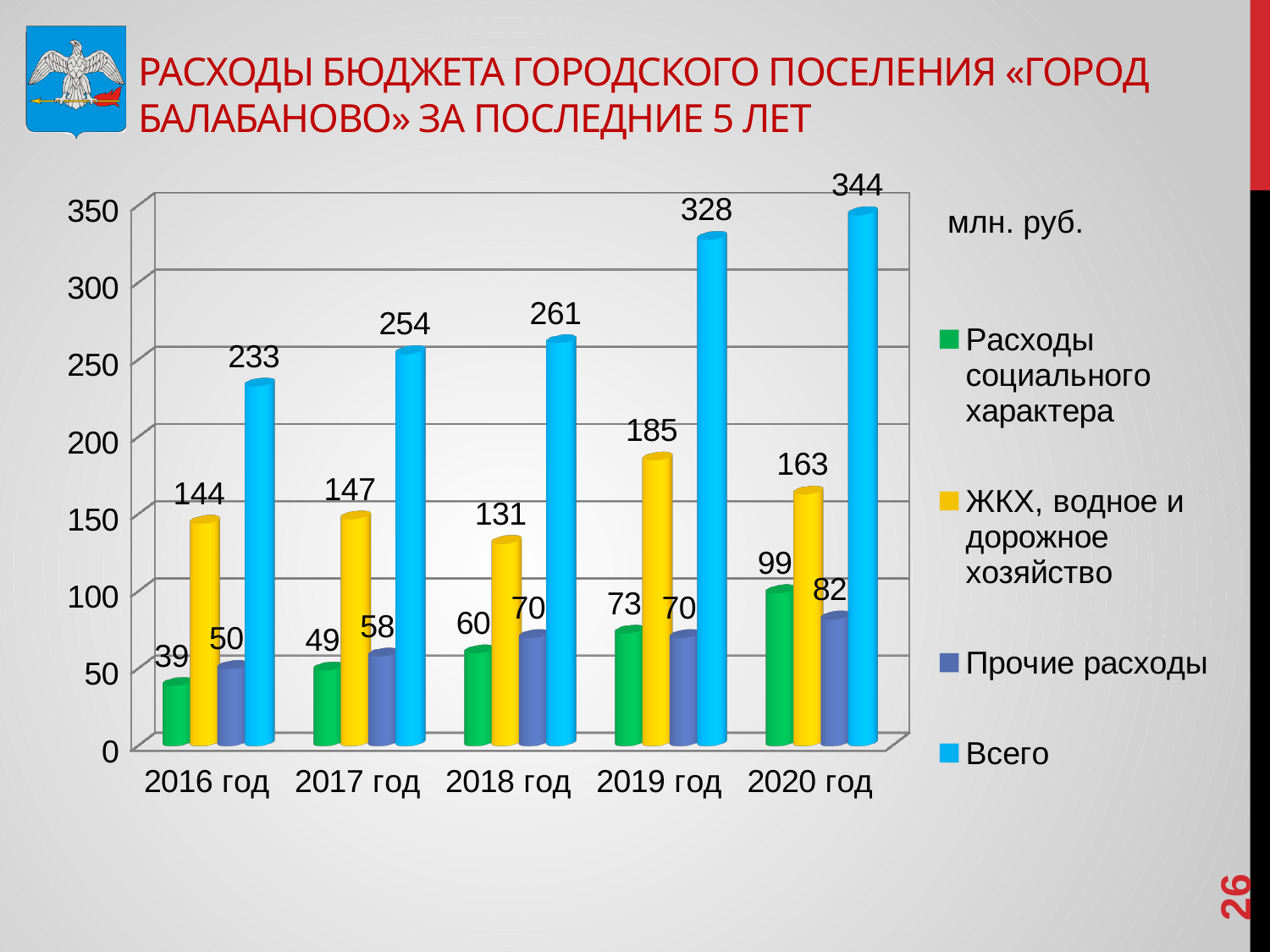
What is the value of «ЖКХ, водное и дорожное хозяйство» for 2019 год? 185 What is the difference between «Всего» in 2020 год and 2016 год? 111 How many years are shown on the x axis? 5 In which year is «Всего» the highest? 2020 год What is the value of «Расходы социального характера» for 2016 год? 39 What kind of chart is shown on the slide? Bar chart In which year is «Расходы социального характера» the lowest? 2016 год How many series does the legend list? 4 What is the value of «Прочие расходы» for 2018 год? 70 Does «Всего» rise or fall from 2016 год to 2020 год? Rises What is the value of «Всего» for 2020 год? 344 Which is larger: «ЖКХ, водное и дорожное хозяйство» in 2019 год or in 2020 год? 2019 год